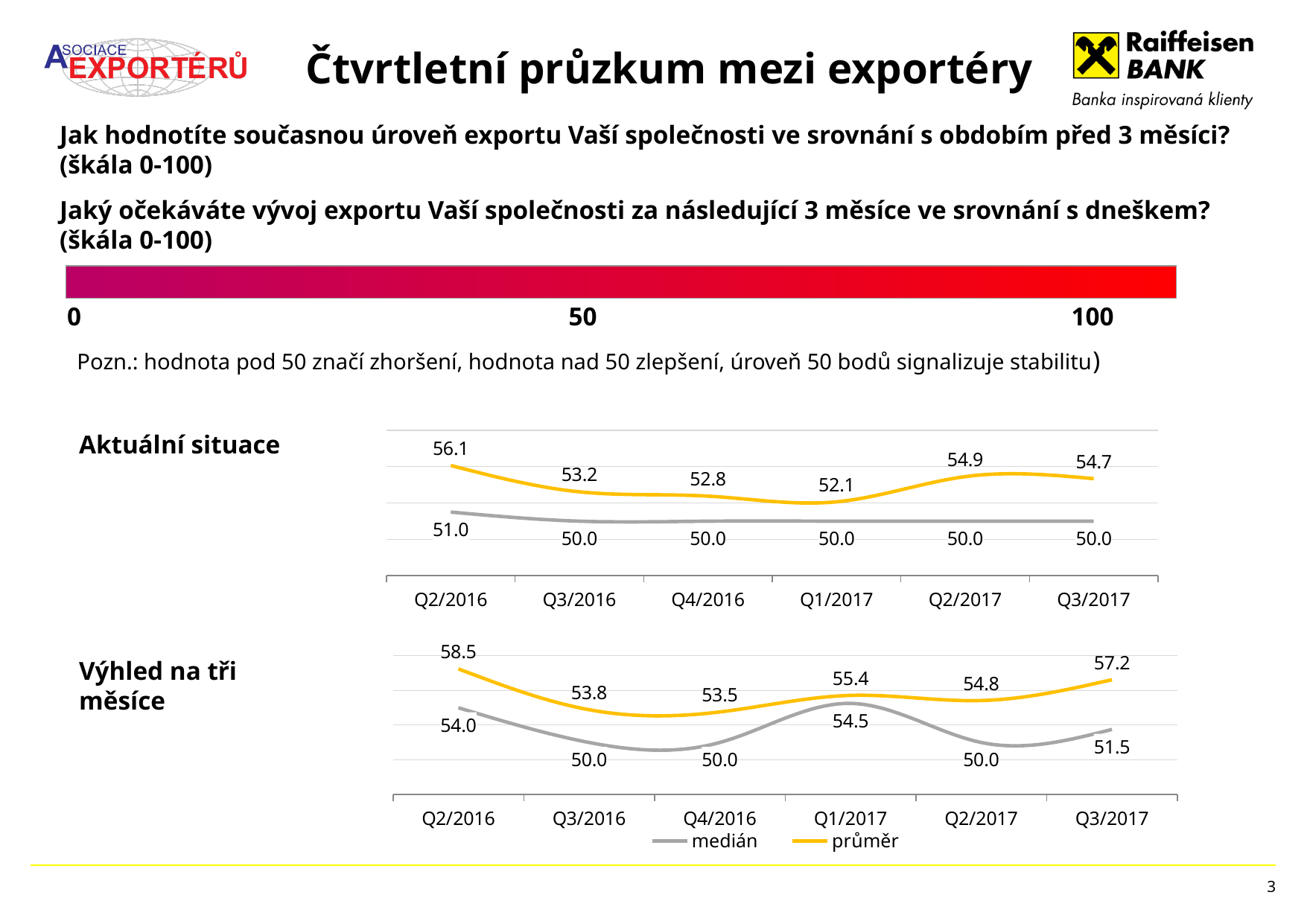
In the 'Aktuální situace' chart, what is the průměr value for Q1/2017? 52.1 In the 'Výhled na tři měsíce' chart, which quarter has the highest průměr value? Q2/2016 In the 'Výhled na tři měsíce' chart, is the průměr value for Q1/2017 larger or smaller than the medián value for Q1/2017? larger In the 'Výhled na tři měsíce' chart, what is the difference between the průměr and medián values for Q2/2016? 4.5 In the 'Aktuální situace' chart, what is the medián value for Q2/2016? 51.0 In the 'Aktuální situace' chart, what is the průměr value for Q2/2016? 56.1 How many series does the legend list? 2 In the 'Aktuální situace' chart, what is the difference between the průměr values for Q2/2017 and Q3/2017? 0.2 In the 'Výhled na tři měsíce' chart, what is the průměr value for Q3/2017? 57.2 In the 'Aktuální situace' chart, which quarter has the lowest průměr value? Q1/2017 In the 'Výhled na tři měsíce' chart, what is the medián value for Q1/2017? 54.5 In the 'Aktuální situace' chart, which quarter has the highest průměr value? Q2/2016